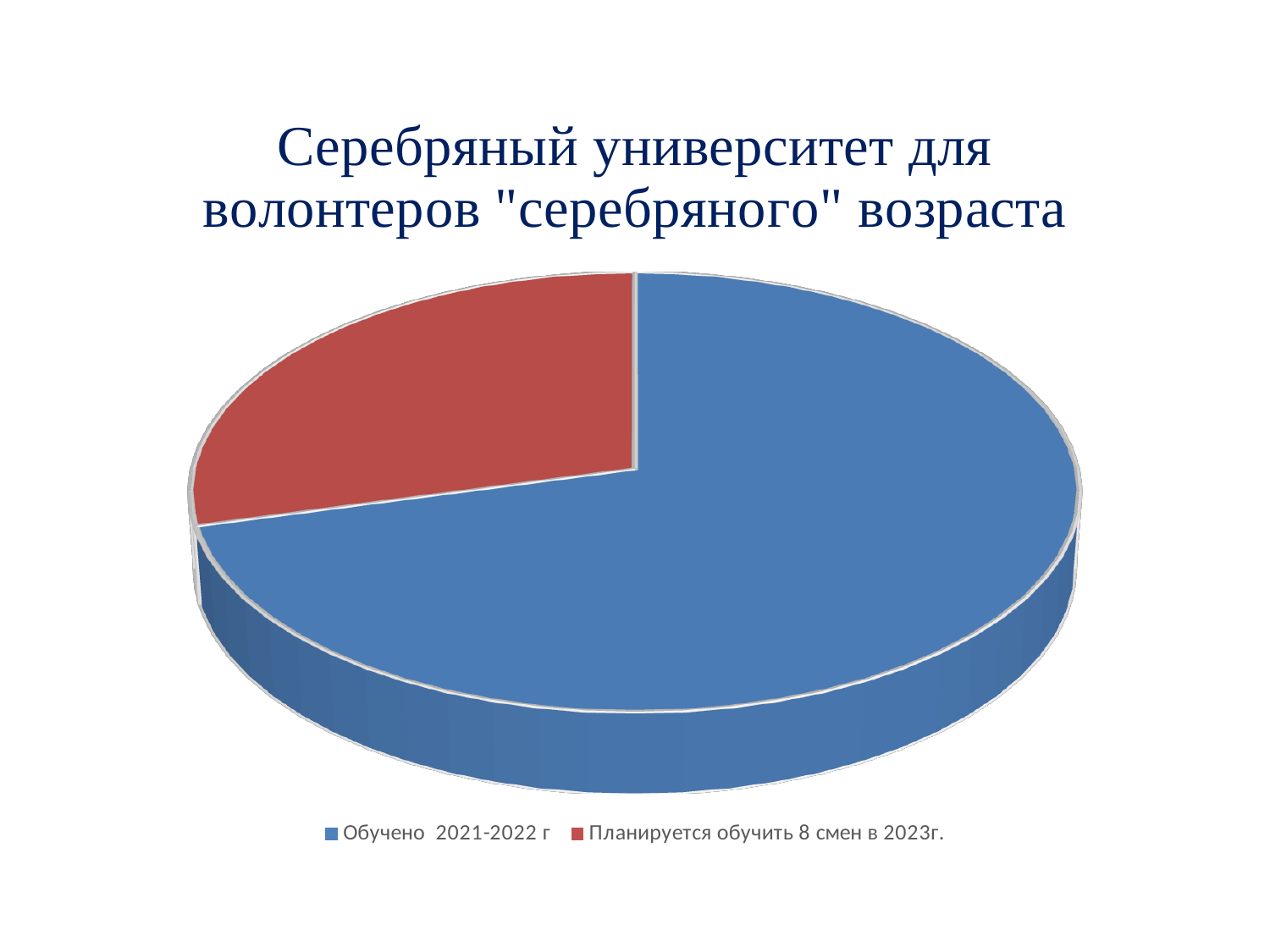
What colour is the slice for "Планируется обучить 8 смен в 2023г."? red What kind of chart is shown on the slide? pie chart What is the title of the chart? Серебряный университет для волонтеров "серебряного" возраста How many entries does the legend list? 2 Which is larger: the slice for "Обучено 2021-2022 г" or the slice for "Планируется обучить 8 смен в 2023г."? Обучено 2021-2022 г Which slice of the pie chart is the smallest? Планируется обучить 8 смен в 2023г. Which slice of the pie chart is the largest? Обучено 2021-2022 г How many slices does the pie chart have? 2